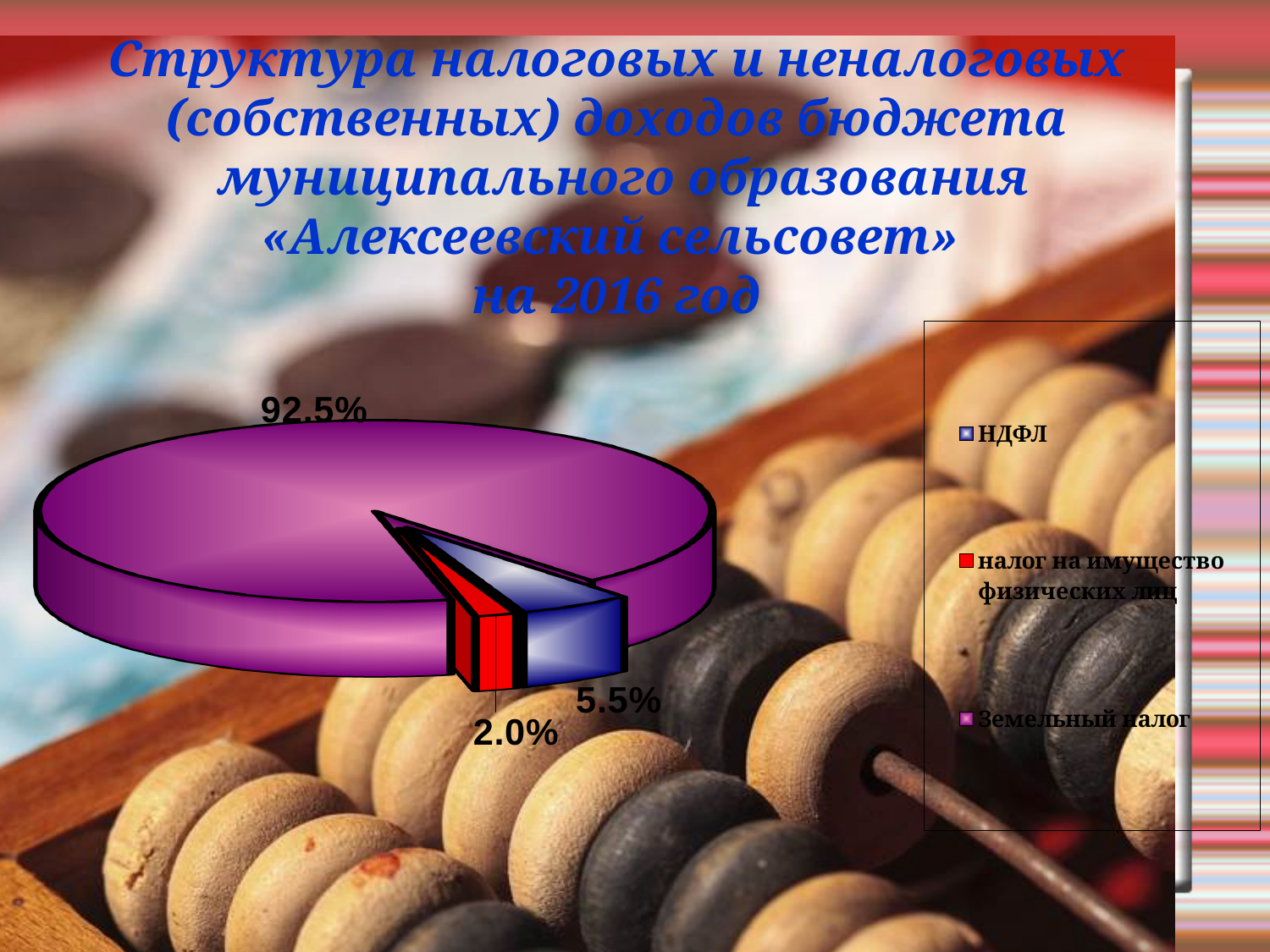
Which category has the smallest share of the pie? налог на имущество физических лиц How many slices does the pie chart have? 3 What share of the pie does НДФЛ have? 5.5% How many entries does the legend list? 3 What is the difference in percentage points between Земельный налог and НДФЛ? 87.0 What is the difference in percentage points between НДФЛ and налог на имущество физических лиц? 3.5 What share of the pie does Земельный налог have? 92.5% What colour is the slice for Земельный налог? purple What kind of chart is shown on the slide? pie chart Which is larger, the share for НДФЛ or the share for налог на имущество физических лиц? НДФЛ What share of the pie does налог на имущество физических лиц have? 2.0% Which category has the largest share of the pie? Земельный налог